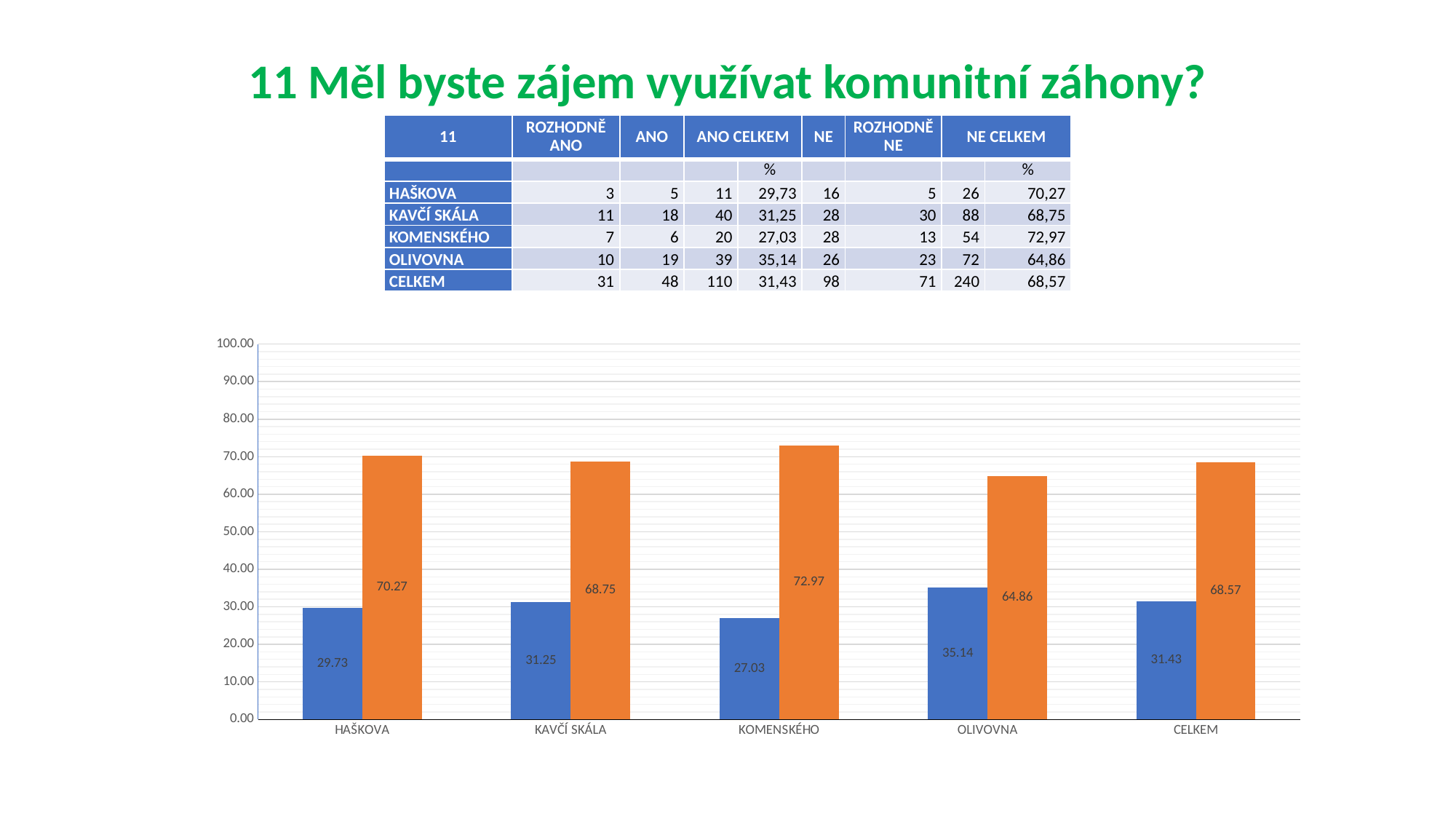
What type of chart is shown on the slide? bar chart How many categories are shown on the x axis of the chart? 5 Is the blue bar for KAVČÍ SKÁLA or the blue bar for OLIVOVNA larger? OLIVOVNA Which category has the highest orange bar? KOMENSKÉHO Is the orange bar for OLIVOVNA greater or less than 70.00? less Which category has the lowest blue bar? KOMENSKÉHO What is the value of the blue bar for HAŠKOVA? 29.73 What is the difference between the orange and blue bars for HAŠKOVA? 40.54 What is the value of the orange bar for KOMENSKÉHO? 72.97 What is the value of the orange bar for CELKEM? 68.57 Which category has the lowest orange bar? OLIVOVNA What is the value of the blue bar for OLIVOVNA? 35.14